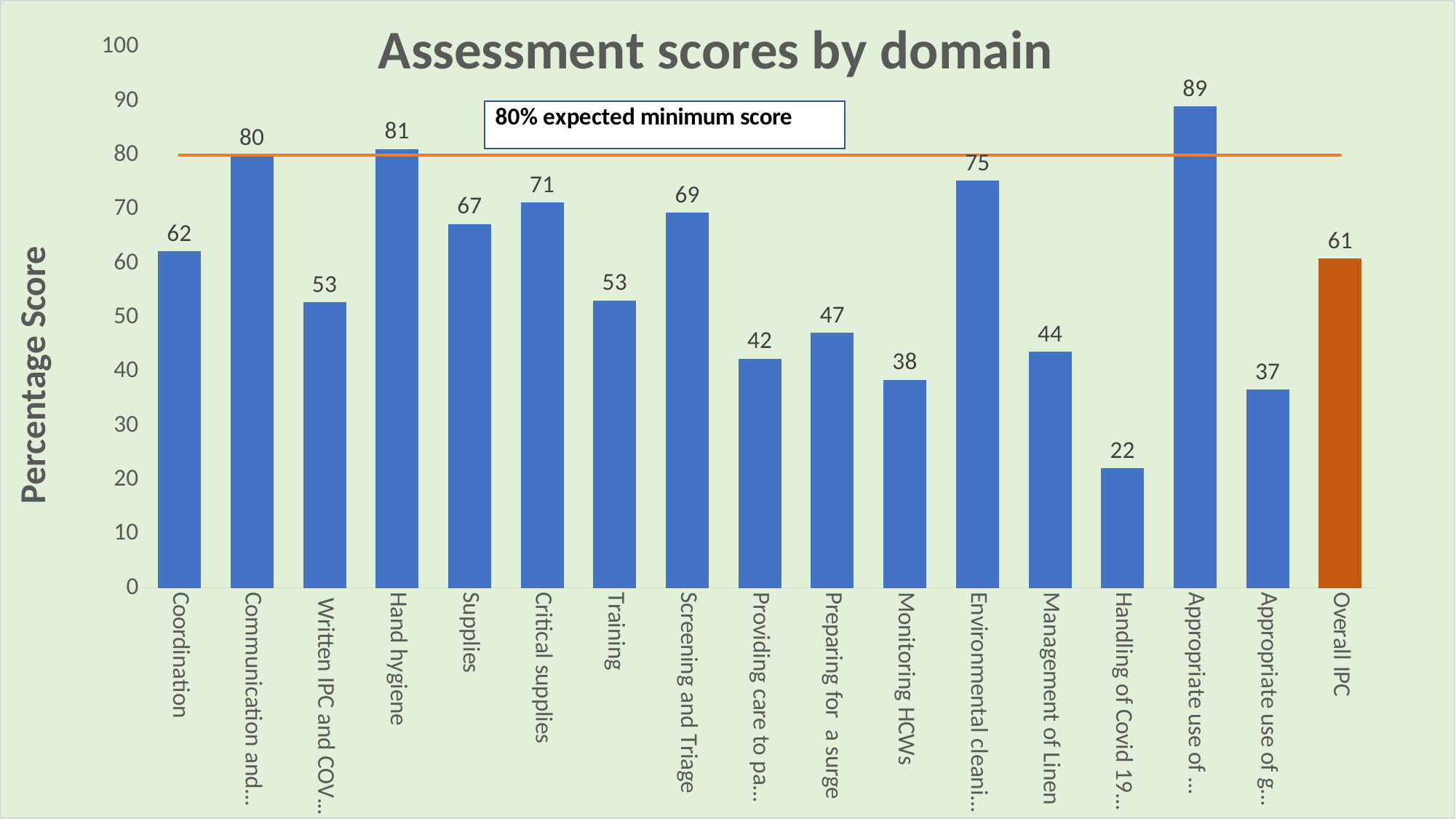
What is the assessment score for Hand hygiene? 81 Which has a higher score, Supplies or Critical supplies? Critical supplies Which domain has the lowest score? Handling of Covid 19 What is the score for Screening and Triage? 69 What is the score for Management of Linen? 44 What is the difference between the Coordination score and the Training score? 9 What type of chart is shown? Bar chart What is the highest score shown on the chart? 89 What is the score for Overall IPC? 61 Is the score for Monitoring HCWs greater or less than 40? less How many bars are shown on the chart? 17 What does the horizontal orange line represent? 80% expected minimum score